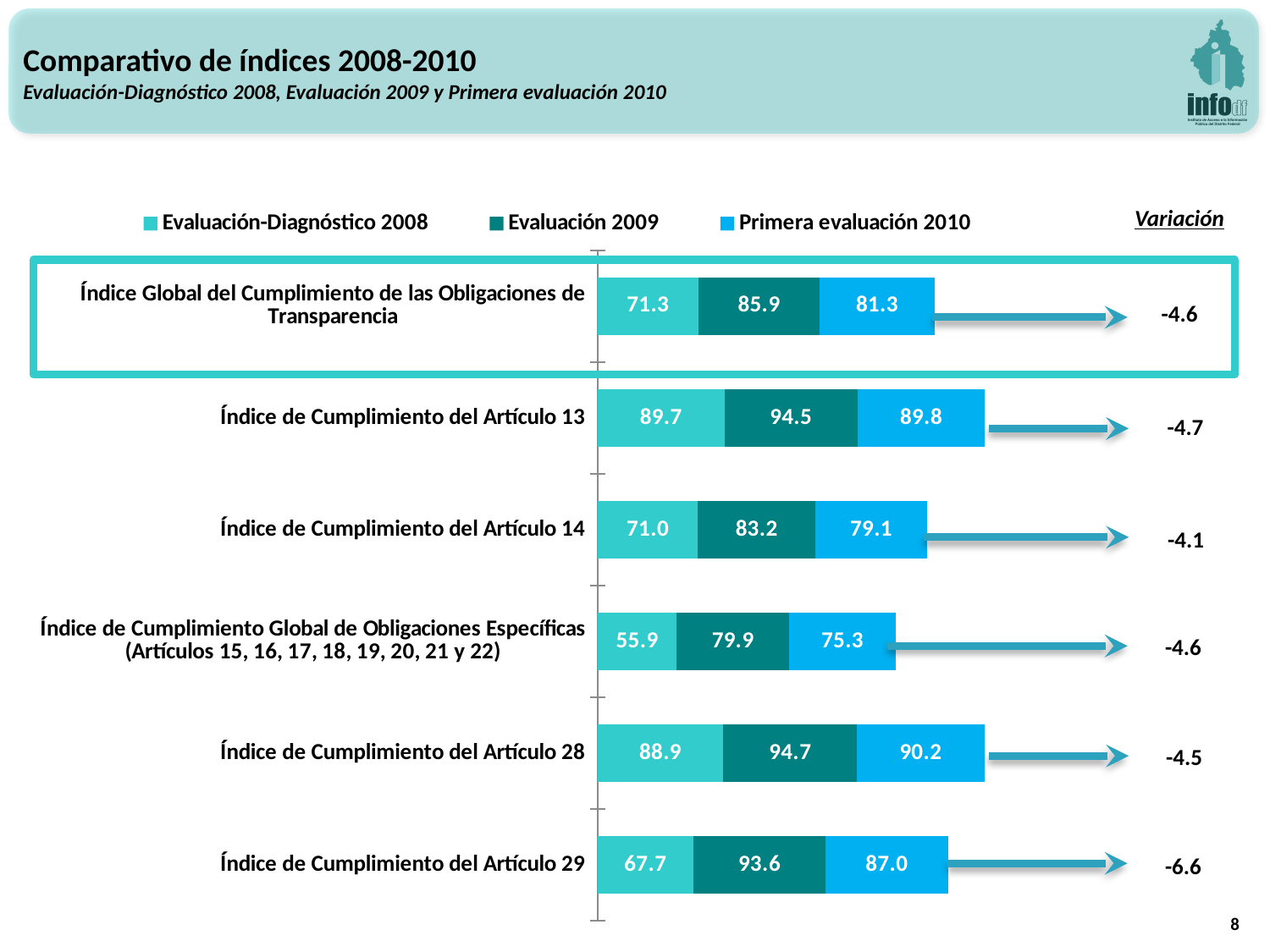
Which index has the highest Primera evaluación 2010 value? Índice de Cumplimiento del Artículo 28 How many indices (categories) are shown in the chart? 6 What is the Evaluación-Diagnóstico 2008 value for the Índice de Cumplimiento Global de Obligaciones Específicas (Artículos 15, 16, 17, 18, 19, 20, 21 y 22)? 55.9 What is the Primera evaluación 2010 value for the Índice de Cumplimiento del Artículo 13? 89.8 What kind of chart is shown on the slide? Stacked bar chart What is the Evaluación 2009 value for the Índice Global del Cumplimiento de las Obligaciones de Transparencia? 85.9 What is the Evaluación 2009 value for the Índice de Cumplimiento del Artículo 29? 93.6 What Variación value is shown for the Índice de Cumplimiento del Artículo 28? -4.5 How many series does the legend list? 3 What is the difference between the Evaluación 2009 and Primera evaluación 2010 values for the Índice de Cumplimiento del Artículo 29? 6.6 Which has the larger Evaluación-Diagnóstico 2008 value: Índice de Cumplimiento del Artículo 13 or Índice de Cumplimiento del Artículo 14? Índice de Cumplimiento del Artículo 13 Which index has the lowest Evaluación-Diagnóstico 2008 value? Índice de Cumplimiento Global de Obligaciones Específicas (Artículos 15, 16, 17, 18, 19, 20, 21 y 22)